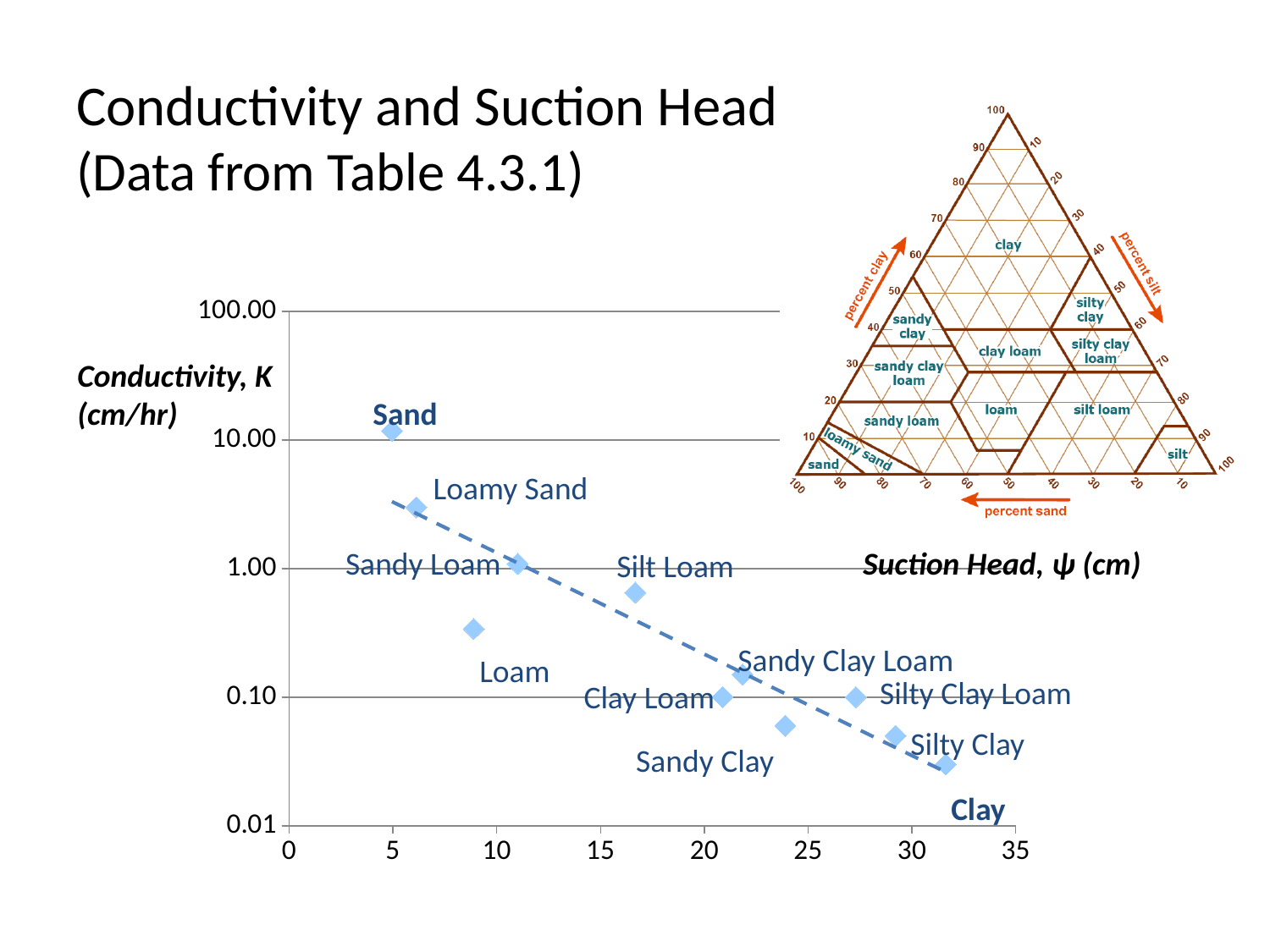
Which soil type has the smallest suction head on the chart? Sand Is the conductivity for Loamy Sand greater or less than 1.00 cm/hr? greater Is the conductivity for Silty Clay greater or less than 0.10 cm/hr? less Which soil type has the highest conductivity on the chart? Sand As suction head increases along the x axis, does conductivity generally rise or fall? Fall Is the conductivity for Silt Loam greater or less than 1.00 cm/hr? less What is the label of the vertical axis of the chart? Conductivity, K (cm/hr) Which soil type has the largest suction head on the chart? Clay How many soil types are plotted as points on the chart? 11 Which soil type has the lowest conductivity on the chart? Clay Which has the higher conductivity, Loamy Sand or Loam? Loamy Sand What kind of chart is used to plot conductivity against suction head? Scatter chart